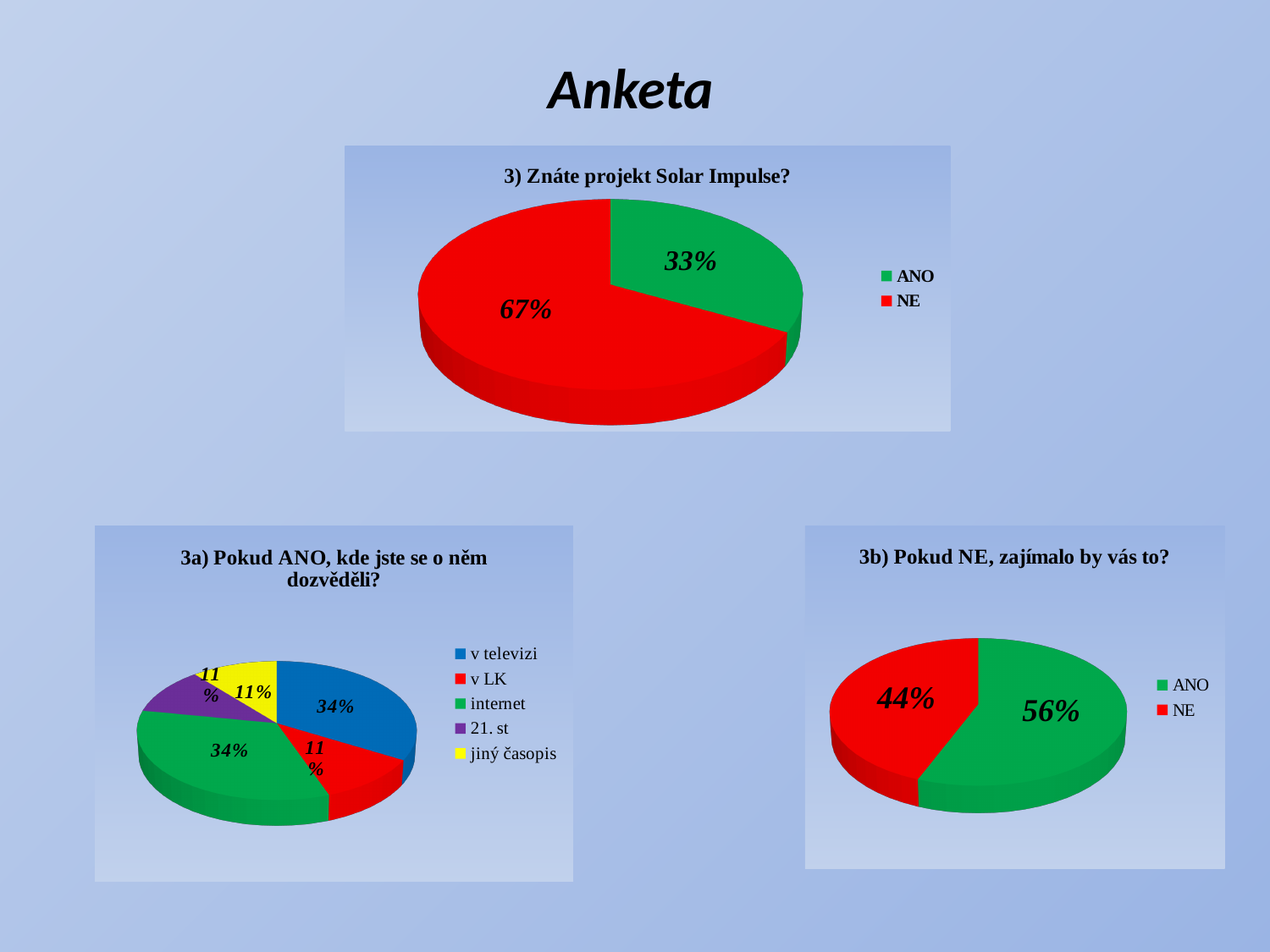
What kind of chart is used for "3b) Pokud NE, zajímalo by vás to?"? pie chart In the chart titled "3b) Pokud NE, zajímalo by vás to?", which answer has the smaller share? NE In the chart titled "3) Znáte projekt Solar Impulse?", what share of respondents answered ANO? 33% In the chart titled "3b) Pokud NE, zajímalo by vás to?", what share of respondents answered NE? 44% In the chart titled "3) Znáte projekt Solar Impulse?", what share of respondents answered NE? 67% In the chart titled "3a) Pokud ANO, kde jste se o něm dozvěděli?", what share is shown for internet? 34% How many categories does the legend list in the chart titled "3a) Pokud ANO, kde jste se o něm dozvěděli?"? 5 In the chart titled "3) Znáte projekt Solar Impulse?", what is the difference in percentage points between NE and ANO? 34 In the chart titled "3) Znáte projekt Solar Impulse?", which answer has the larger share? NE In the chart titled "3a) Pokud ANO, kde jste se o něm dozvěděli?", what share is shown for jiný časopis? 11% In the chart titled "3b) Pokud NE, zajímalo by vás to?", what share of respondents answered ANO? 56% In the chart titled "3a) Pokud ANO, kde jste se o něm dozvěděli?", which is larger: v televizi or v LK? v televizi